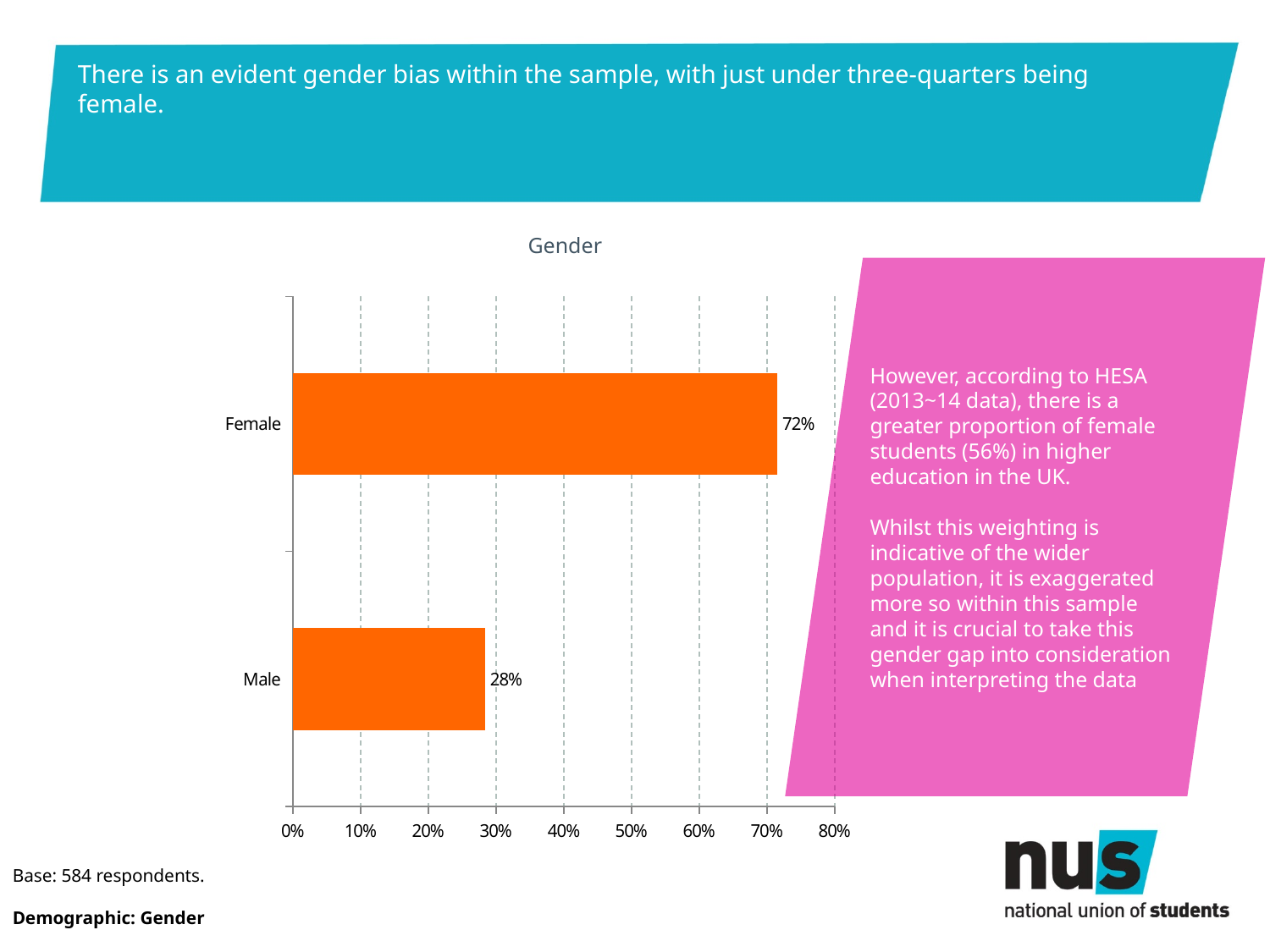
What kind of chart is the Gender chart? Bar chart What is the title of the chart on the slide? Gender What is the highest value shown on the x axis of the Gender chart? 80% What is the value for Female in the Gender chart? 72% Which is larger in the Gender chart, the value for Female or the value for Male? Female What is the value for Male in the Gender chart? 28% Is the value for Male in the Gender chart greater or less than 30%? less What is the difference between the Female and Male values in the Gender chart? 44% Is the value for Female in the Gender chart greater or less than 70%? greater Which category has the lowest value in the Gender chart? Male How many categories are shown in the Gender chart? 2 Which category has the highest value in the Gender chart? Female